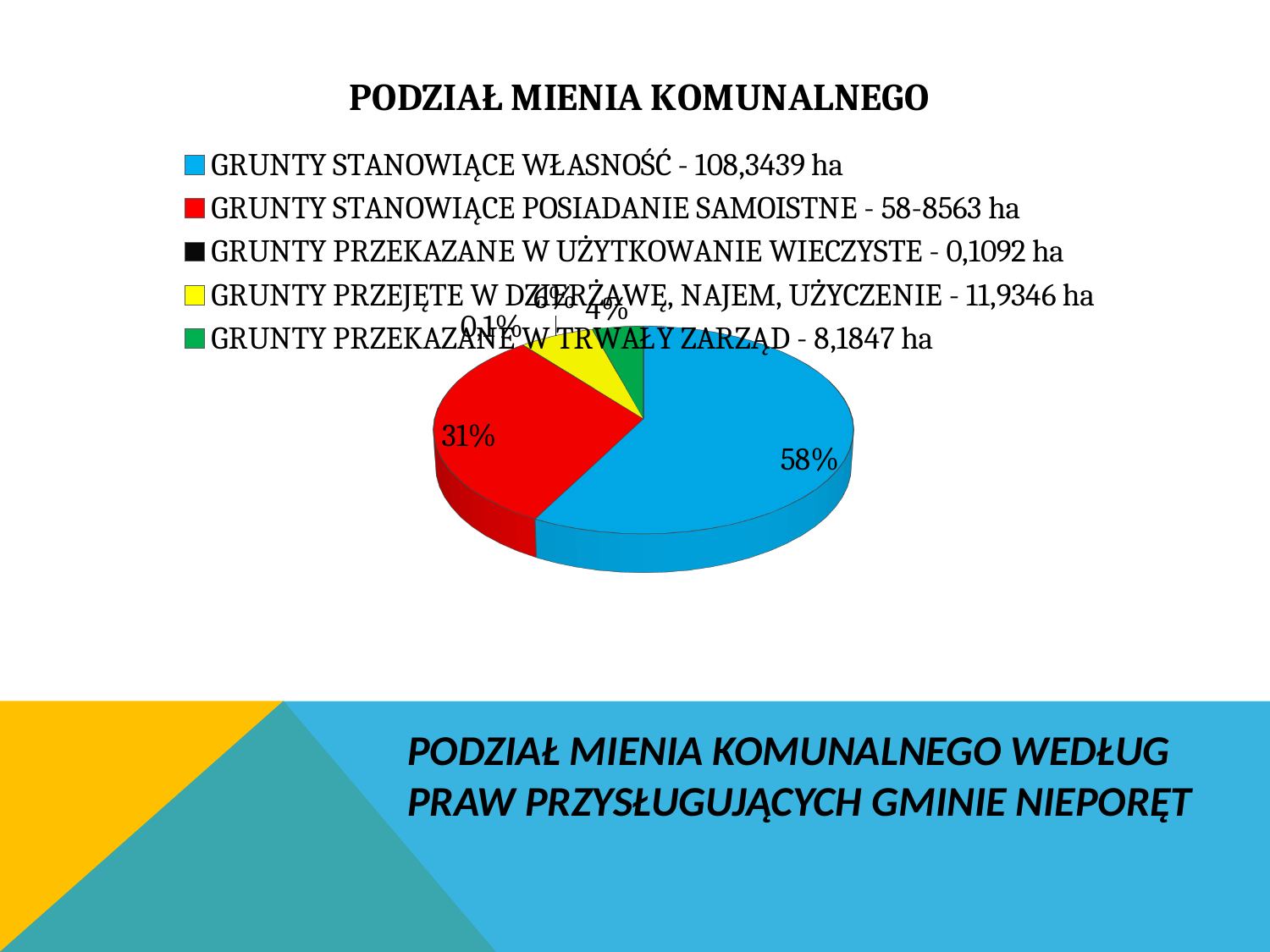
What is the difference in percentage points between the shares of GRUNTY STANOWIĄCE WŁASNOŚĆ and GRUNTY STANOWIĄCE POSIADANIE SAMOISTNE? 27% Which category has the largest share of the pie? GRUNTY STANOWIĄCE WŁASNOŚĆ What share of the pie is GRUNTY PRZEKAZANE W TRWAŁY ZARZĄD? 4% Which slice is larger: GRUNTY STANOWIĄCE POSIADANIE SAMOISTNE or GRUNTY PRZEKAZANE W TRWAŁY ZARZĄD? GRUNTY STANOWIĄCE POSIADANIE SAMOISTNE How many slices does the pie chart have? 5 What share of the pie is GRUNTY STANOWIĄCE WŁASNOŚĆ? 58% What is the title of the chart? PODZIAŁ MIENIA KOMUNALNEGO What share of the pie is GRUNTY STANOWIĄCE POSIADANIE SAMOISTNE? 31% Which category has the smallest share of the pie? GRUNTY PRZEKAZANE W UŻYTKOWANIE WIECZYSTE According to the legend, what area in ha is given for GRUNTY STANOWIĄCE WŁASNOŚĆ? 108,3439 ha What kind of chart is shown on the slide? pie chart